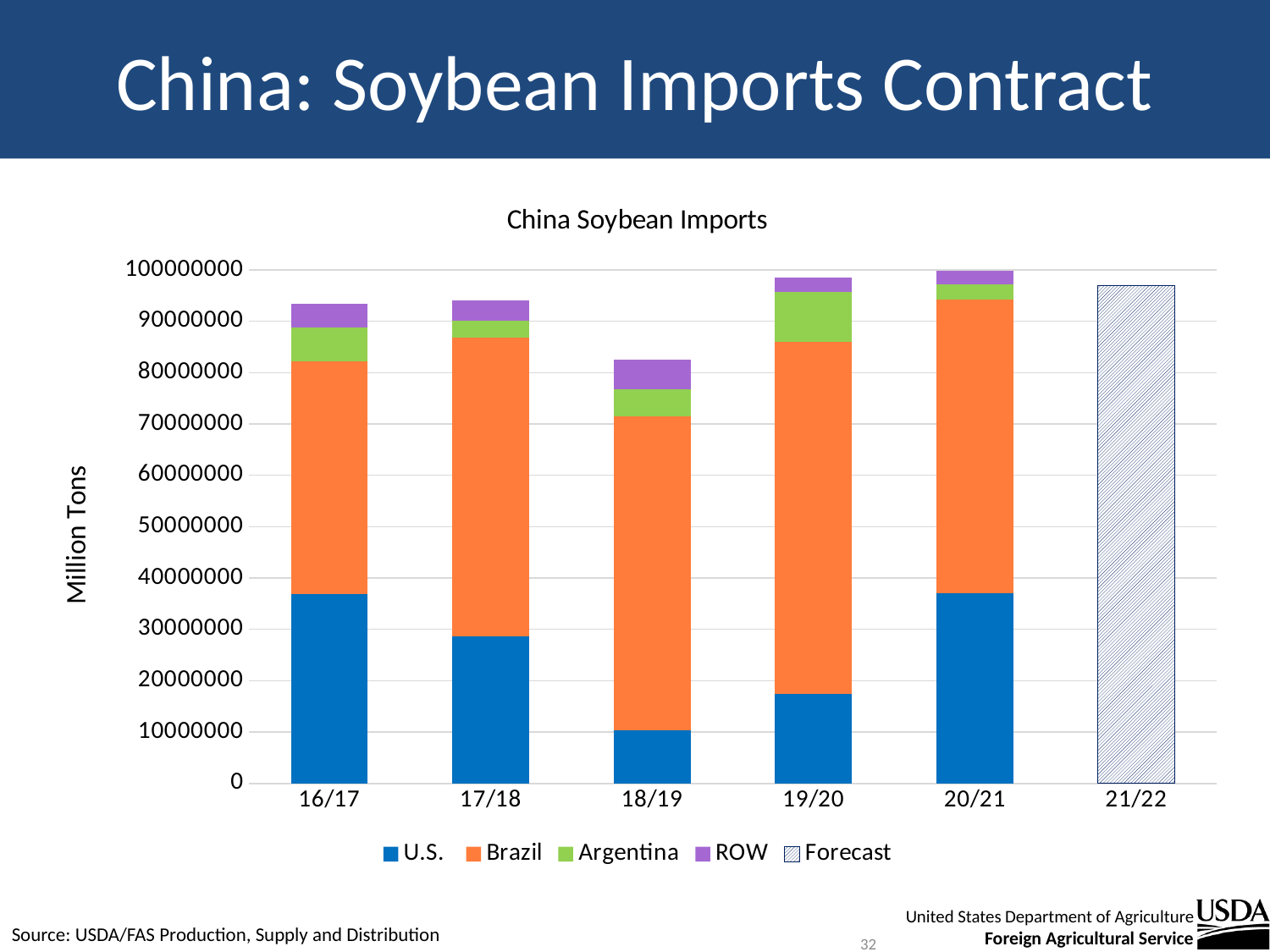
Is the U.S. value for 18/19 greater or less than 20000000? less Is the Forecast value for 21/22 greater or less than 90000000? greater Is the total for 16/17 greater or less than 90000000? greater What type of chart is shown on the slide? Stacked bar chart Which is larger, the U.S. segment in 17/18 or in 19/20? 17/18 Which marketing year has the lowest total soybean imports? 18/19 Which marketing year has the smallest U.S. segment? 18/19 How many marketing years are shown on the x axis? 6 Does the U.S. segment rise or fall from 16/17 to 18/19? Fall How many series does the legend list? 5 What is the label on the y axis? Million Tons